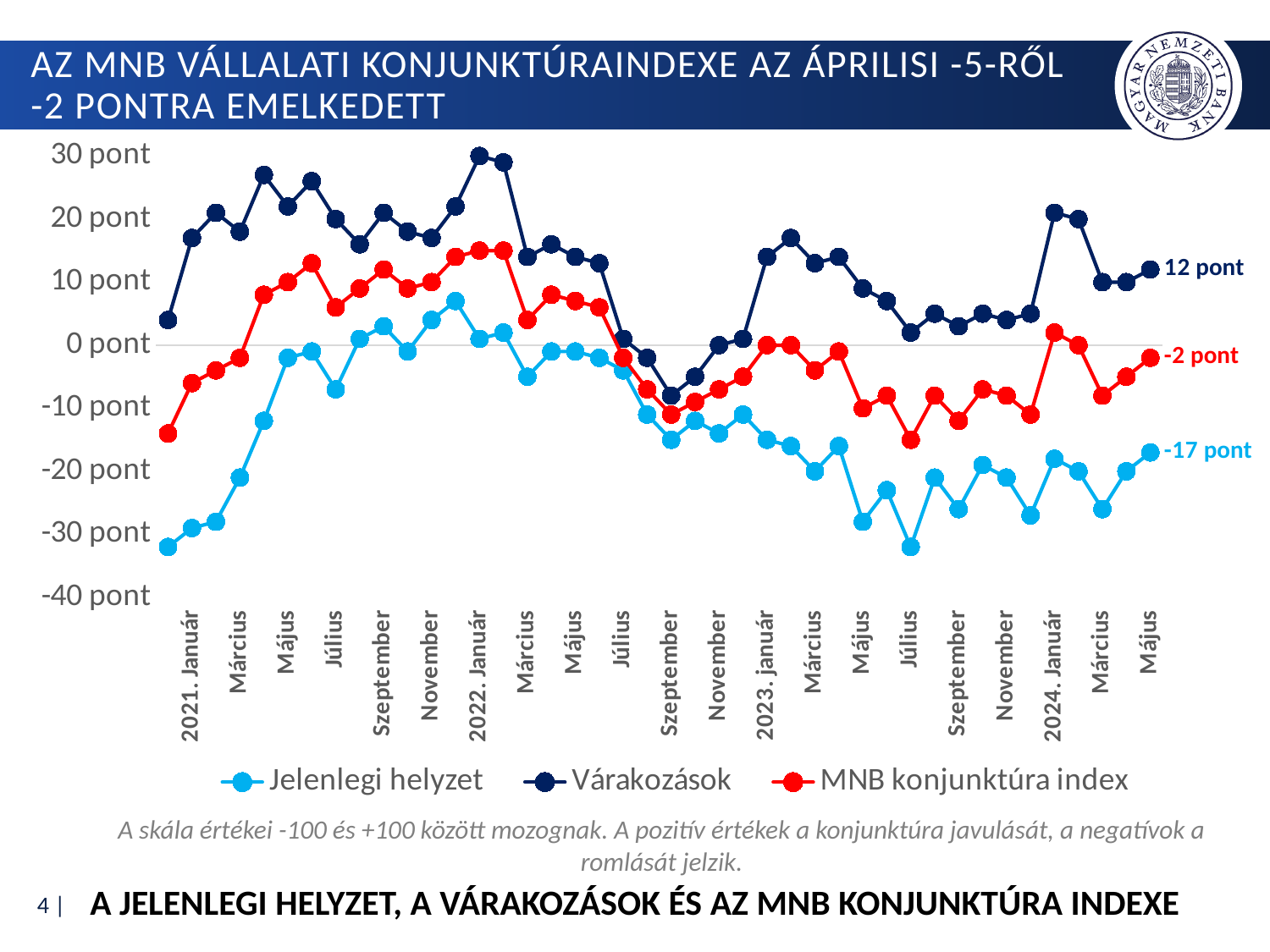
Which series has the highest value at the last point (Május 2024)? Várakozások Is the value of the Várakozások series at 2022. Január greater or less than 20 pont? greater What is the difference between the MNB konjunktúra index value and the Jelenlegi helyzet value at the last point (Május 2024)? 15 pont What is the difference between the Várakozások value and the MNB konjunktúra index value at the last point (Május 2024)? 14 pont What kind of chart is shown on the slide? Line chart Does the Jelenlegi helyzet series rise or fall between 2021. Január and Május 2021? Rise How many series does the legend list? 3 What is the value of the MNB konjunktúra index at the last point (Május 2024)? -2 pont What is the value of the Jelenlegi helyzet series at the last point (Május 2024)? -17 pont Which series has the lowest value at the last point (Május 2024)? Jelenlegi helyzet What is the value of the Várakozások series at the last point (Május 2024)? 12 pont